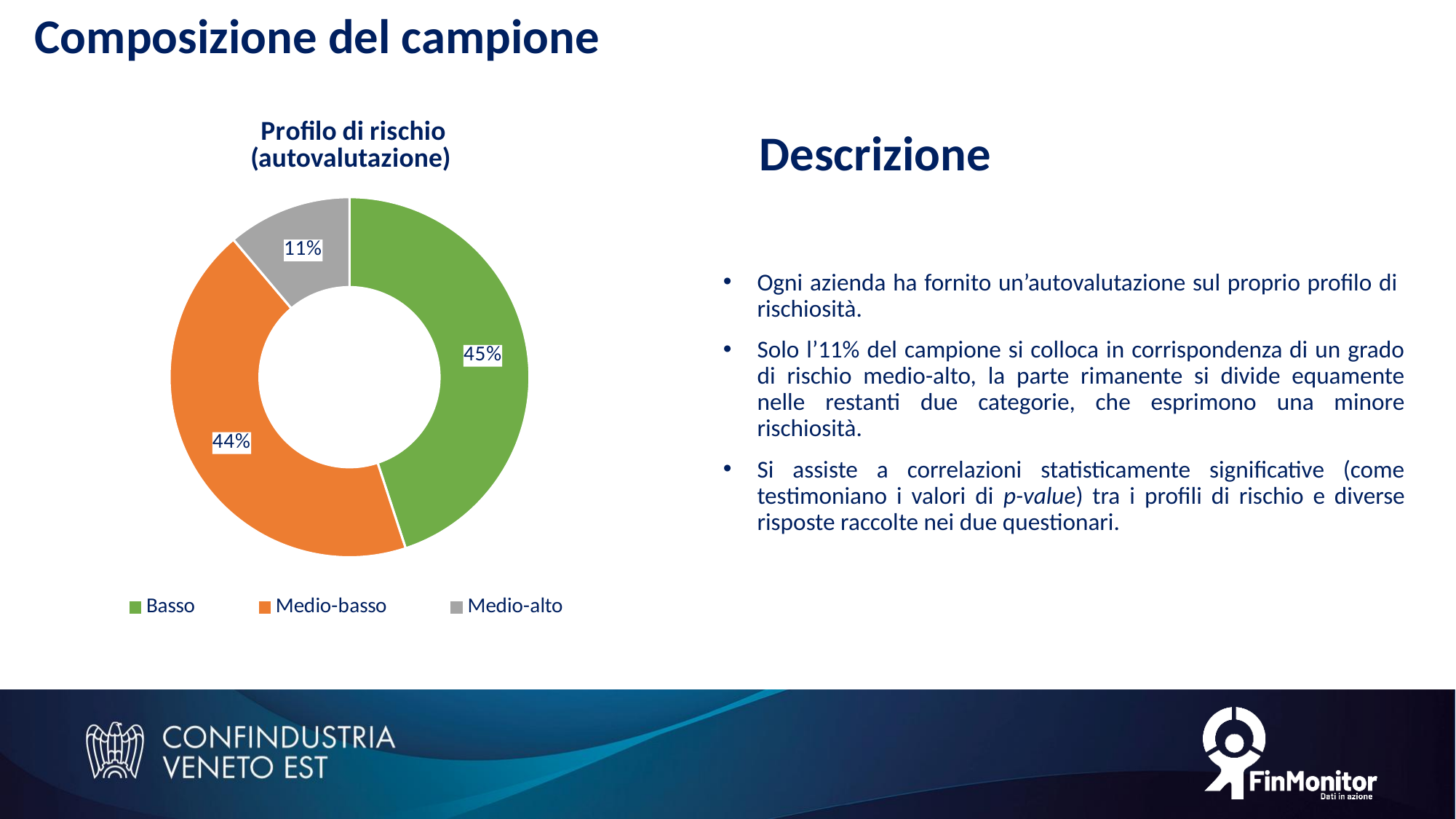
What share of the sample has a 'Medio-basso' risk profile? 44% Which is larger, the share for 'Medio-basso' or the share for 'Medio-alto'? Medio-basso What kind of chart is shown on the slide? Pie chart (doughnut) What share of the sample has a 'Basso' risk profile? 45% Which risk profile category has the smallest share? Medio-alto What is the title of the chart? Profilo di rischio (autovalutazione) Which risk profile category has the largest share? Basso What is the difference in percentage points between the 'Basso' and 'Medio-alto' shares? 34 How many categories does the chart show? 3 Which colour represents the 'Medio-basso' category in the chart? Orange What share of the sample has a 'Medio-alto' risk profile? 11% What is the difference in percentage points between the 'Medio-basso' and 'Medio-alto' shares? 33